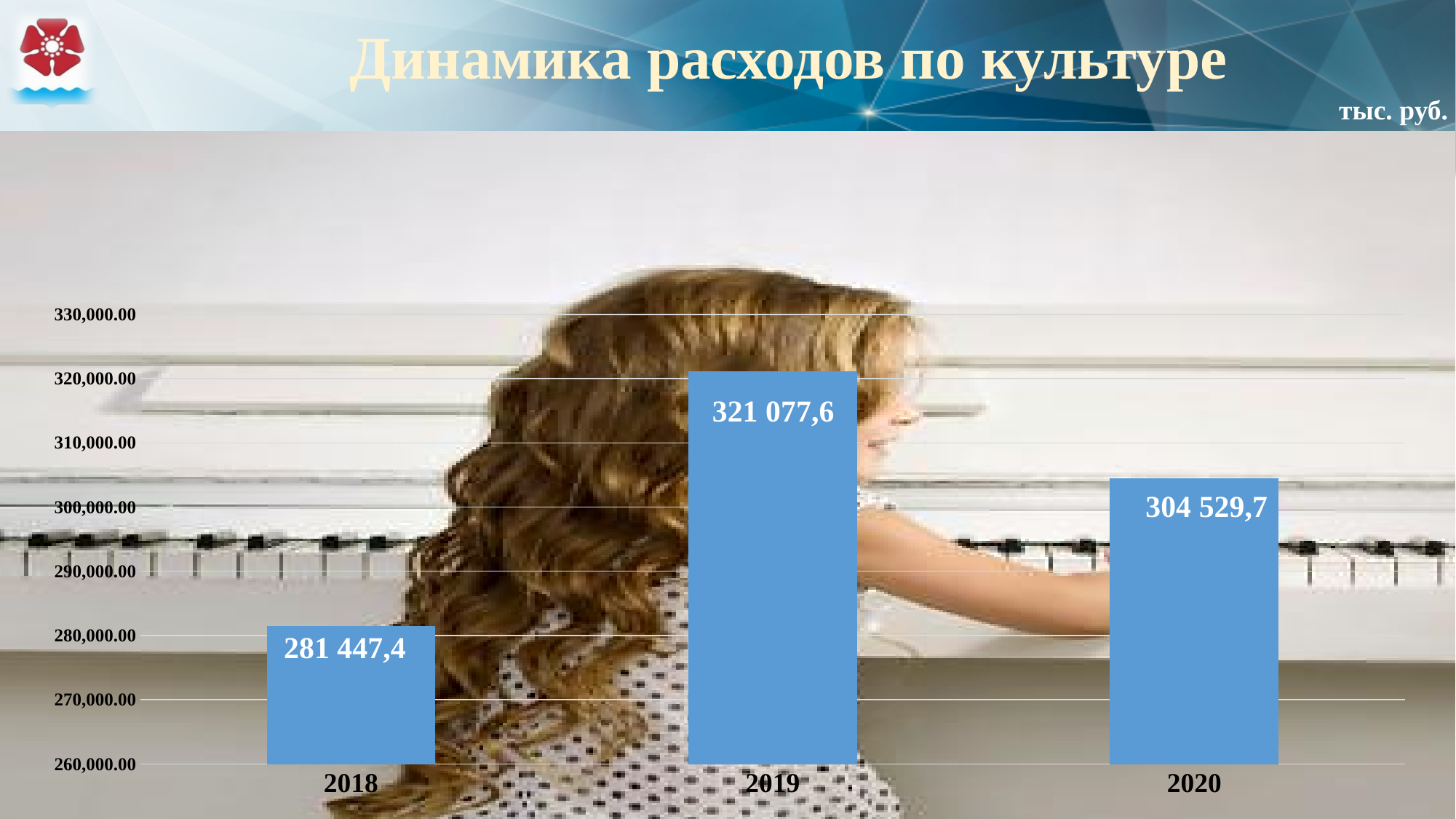
What is the difference between the values for 2019 and 2020? 16 547,9 Which is larger, the value for 2020 or the value for 2018? 2020 What is the value for 2020? 304 529,7 What kind of chart is shown on the slide? bar chart Which year has the lowest value? 2018 What is the value for 2019? 321 077,6 What is the title of the chart? Динамика расходов по культуре Is the value for 2020 greater or less than 300,000.00? greater Which year has the highest value? 2019 How many years are shown on the chart? 3 What is the value for 2018? 281 447,4 What is the difference between the values for 2019 and 2018? 39 630,2